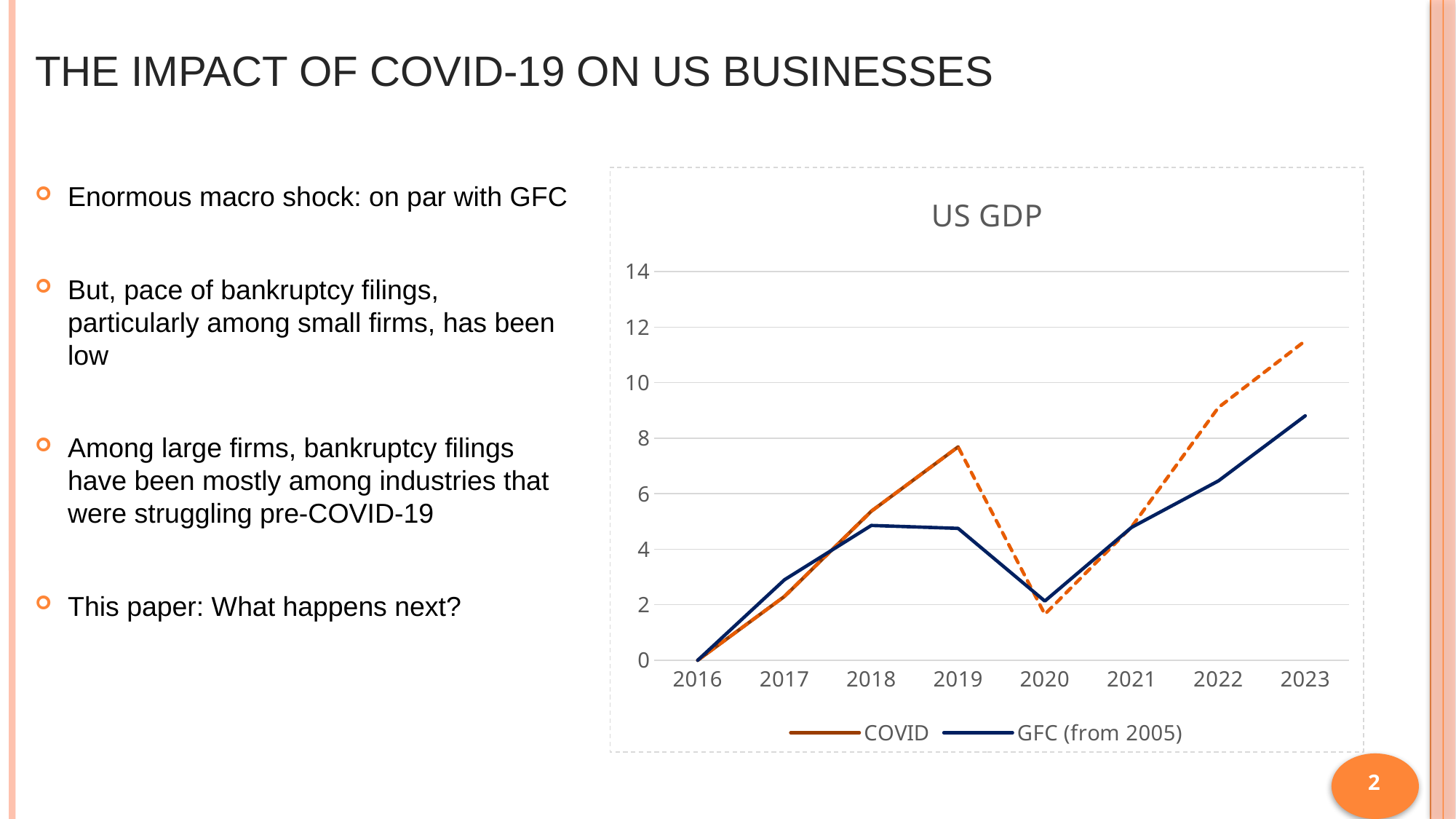
In 2019, which series has the higher value, COVID or GFC (from 2005)? COVID How many series does the legend list? 2 What is the title of the chart? US GDP How many years are shown on the x axis of the chart? 8 What kind of chart is shown on the slide? Line chart Does the GFC (from 2005) series rise or fall between 2020 and 2023? Rise Is the GFC (from 2005) value for 2023 greater or less than 10? less Is the COVID value for 2019 greater or less than 6? greater